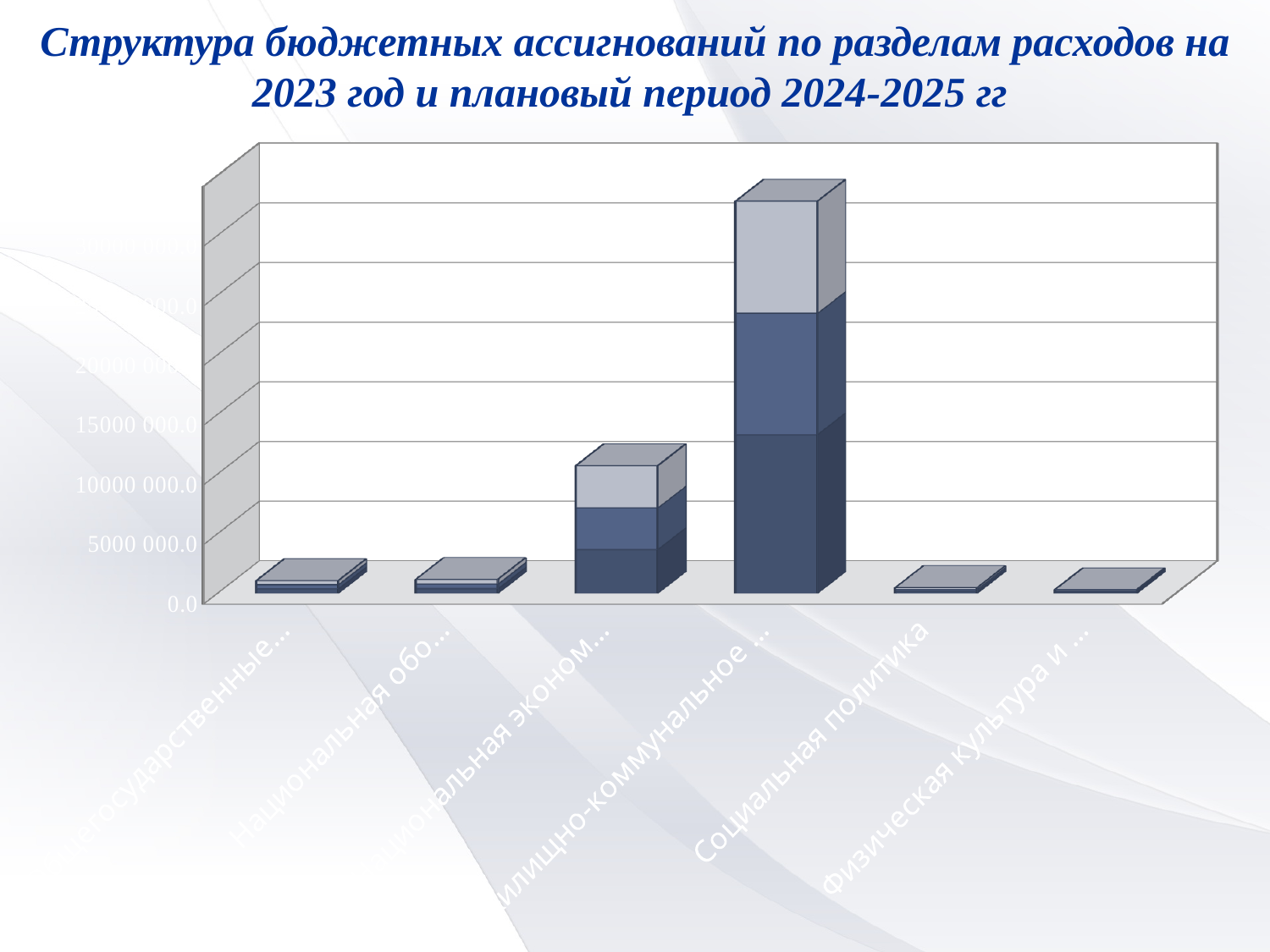
How many categories are shown along the x axis of the chart? 6 What kind of chart is shown on the slide? Stacked bar chart Which bar is taller: Жилищно-коммунальное or Национальная эконом...? Жилищно-коммунальное Is the total value for the Общегосударственные... bar greater or less than 5000 000.0? less Which category has the tallest bar in the chart? Жилищно-коммунальное ... Which bar is taller: Национальная эконом... or Общегосударственные...? Национальная эконом... Is the total value for the Национальная эконом... bar greater or less than 15000 000.0? less Is the total value for the Социальная политика bar greater or less than 5000 000.0? less What is the title of the slide containing the chart? Структура бюджетных ассигнований по разделам расходов на 2023 год и плановый период 2024-2025 гг How many stacked segments make up the tallest bar in the chart? 3